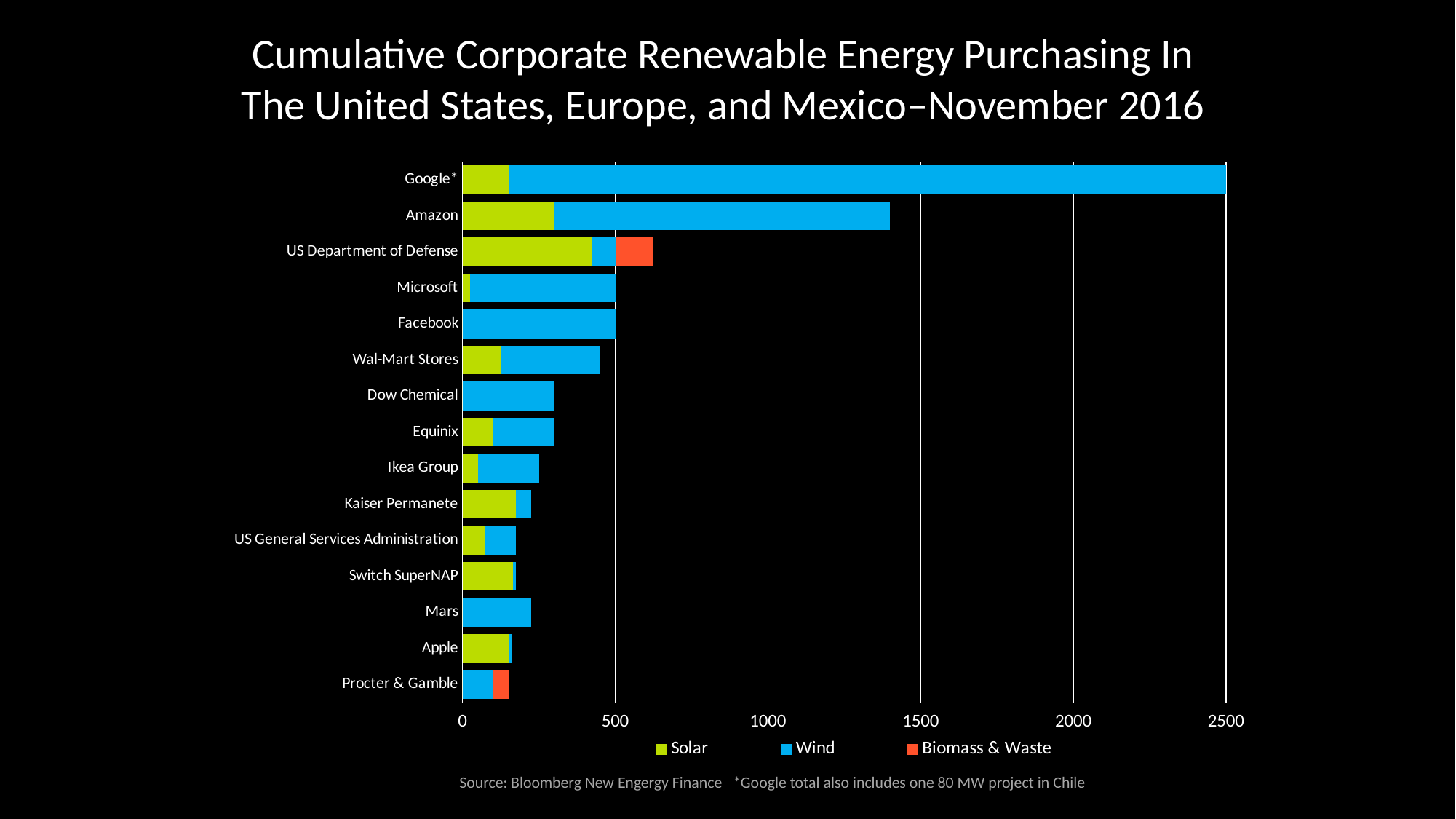
Is the total value for Wal-Mart Stores greater or less than 500? less Which is larger, the total for Wal-Mart Stores or the total for Dow Chemical? Wal-Mart Stores What kind of chart is shown on the slide? Stacked bar chart Which is larger, the total for Google* or the total for Amazon? Google* Which organization has the largest Solar segment? US Department of Defense Is the total value for Amazon greater or less than 1000? greater Is the total value for US Department of Defense greater or less than 500? greater What is the total value of the bar for Facebook? 500 How many series does the legend list? 3 How many organizations are shown on the chart? 15 Which organization has the highest cumulative renewable energy purchasing? Google* Which series is shown in orange in the legend? Biomass & Waste